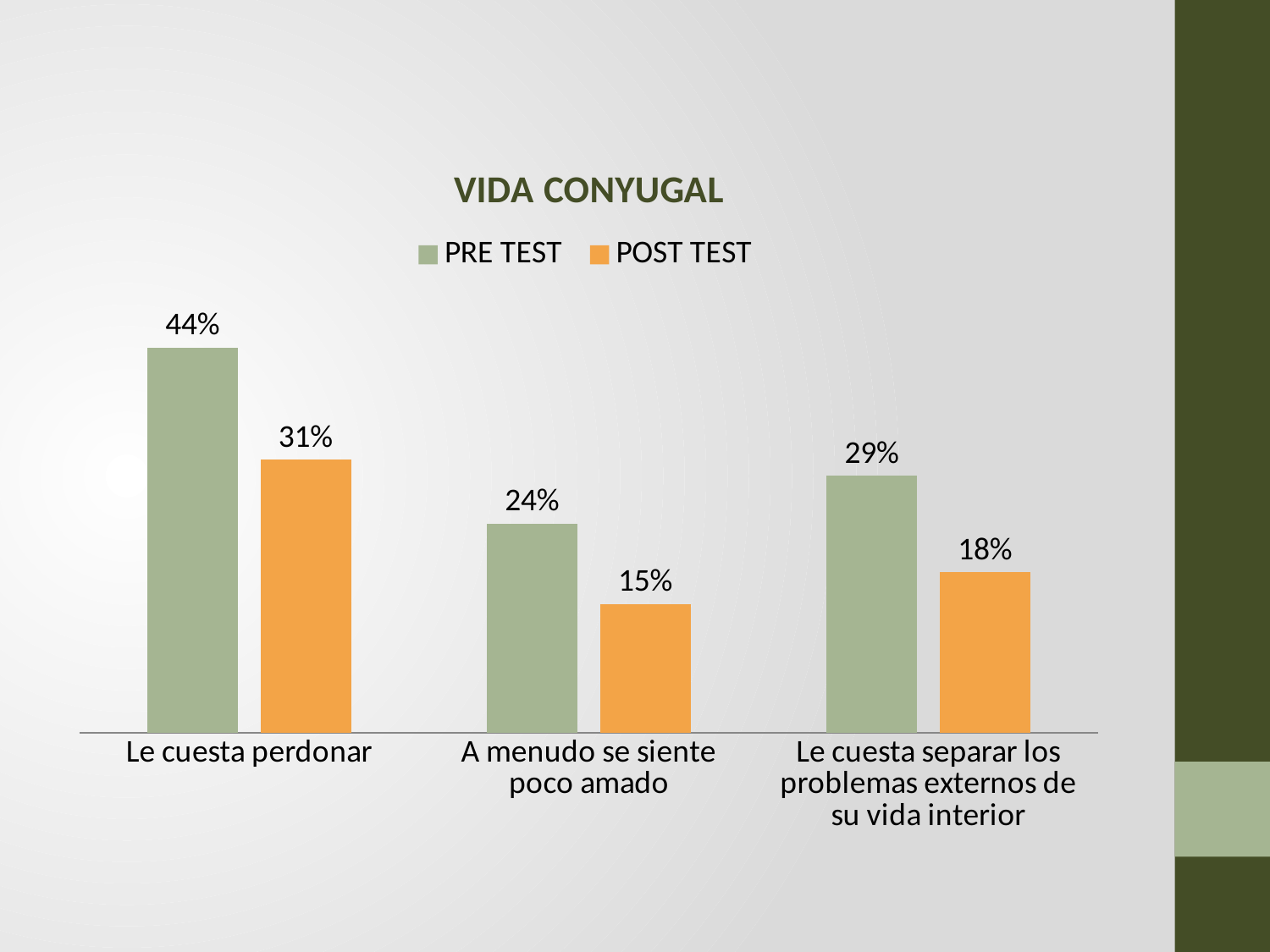
How many series does the legend list? 2 What is the POST TEST value for "A menudo se siente poco amado"? 15% What is the title of the chart? VIDA CONYUGAL Which is larger: the PRE TEST value for "A menudo se siente poco amado" or the POST TEST value for "Le cuesta perdonar"? POST TEST value for "Le cuesta perdonar" What is the difference between the PRE TEST and POST TEST values for "Le cuesta separar los problemas externos de su vida interior"? 11% What kind of chart is shown on the slide? Bar chart What is the PRE TEST value for "Le cuesta perdonar"? 44% How many categories are shown on the x axis? 3 Which category has the highest PRE TEST value? Le cuesta perdonar Which category has the lowest POST TEST value? A menudo se siente poco amado What is the difference between the PRE TEST and POST TEST values for "Le cuesta perdonar"? 13% What is the POST TEST value for "Le cuesta separar los problemas externos de su vida interior"? 18%